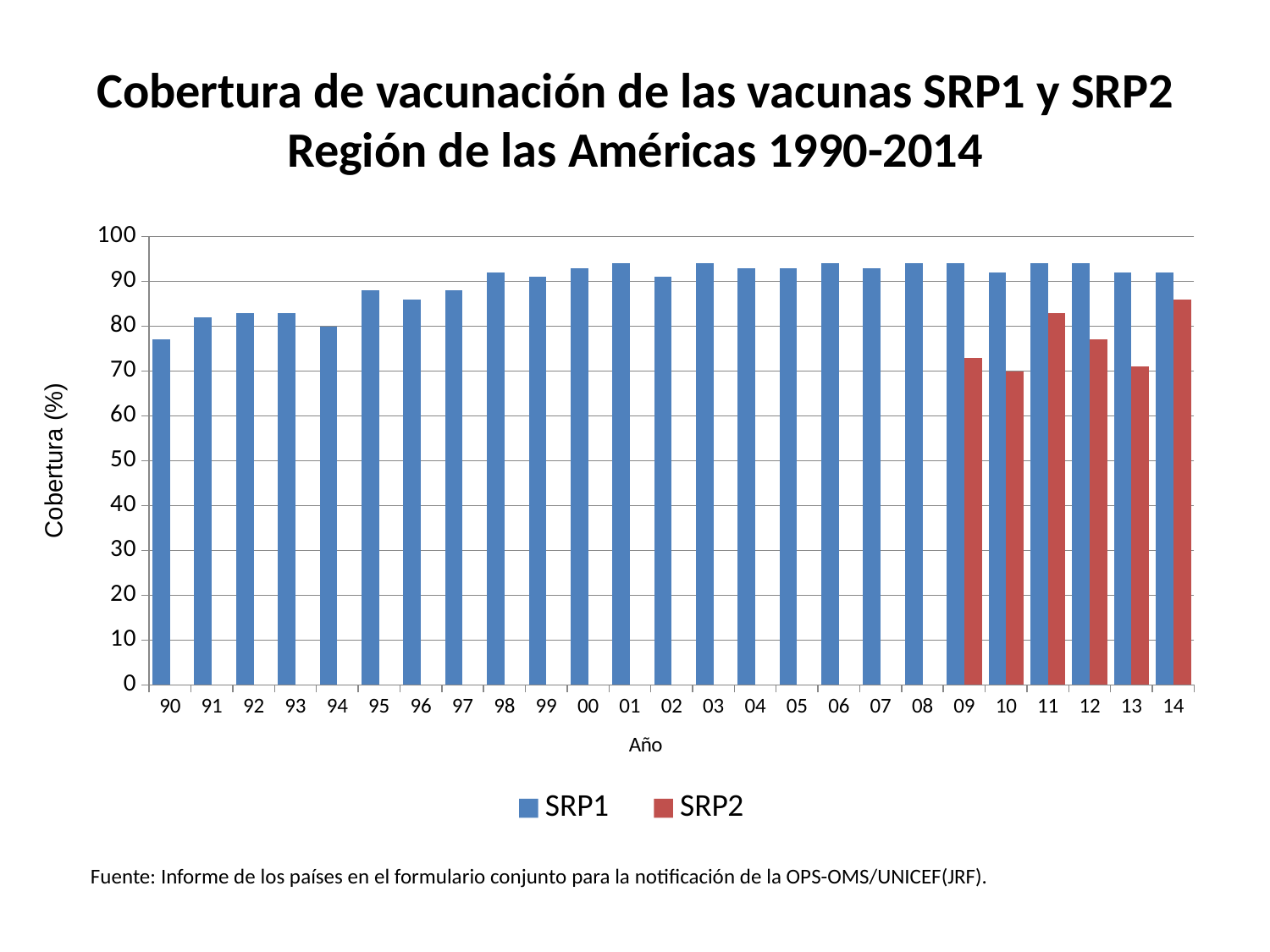
Is the SRP1 value for 90 greater or less than 80? less Which is larger, the SRP2 value for 10 or the SRP2 value for 14? 14 How many series does the legend list? 2 Is the SRP2 value for 14 greater or less than 80? greater Is the SRP2 value for 12 greater or less than 80? less How many years are shown along the x axis? 25 In 11, which is larger, SRP1 or SRP2? SRP1 Which year has the lowest SRP1 coverage? 90 Which year has the highest SRP2 coverage? 14 What kind of chart is shown on the slide? Bar chart What is the label of the y axis? Cobertura (%)